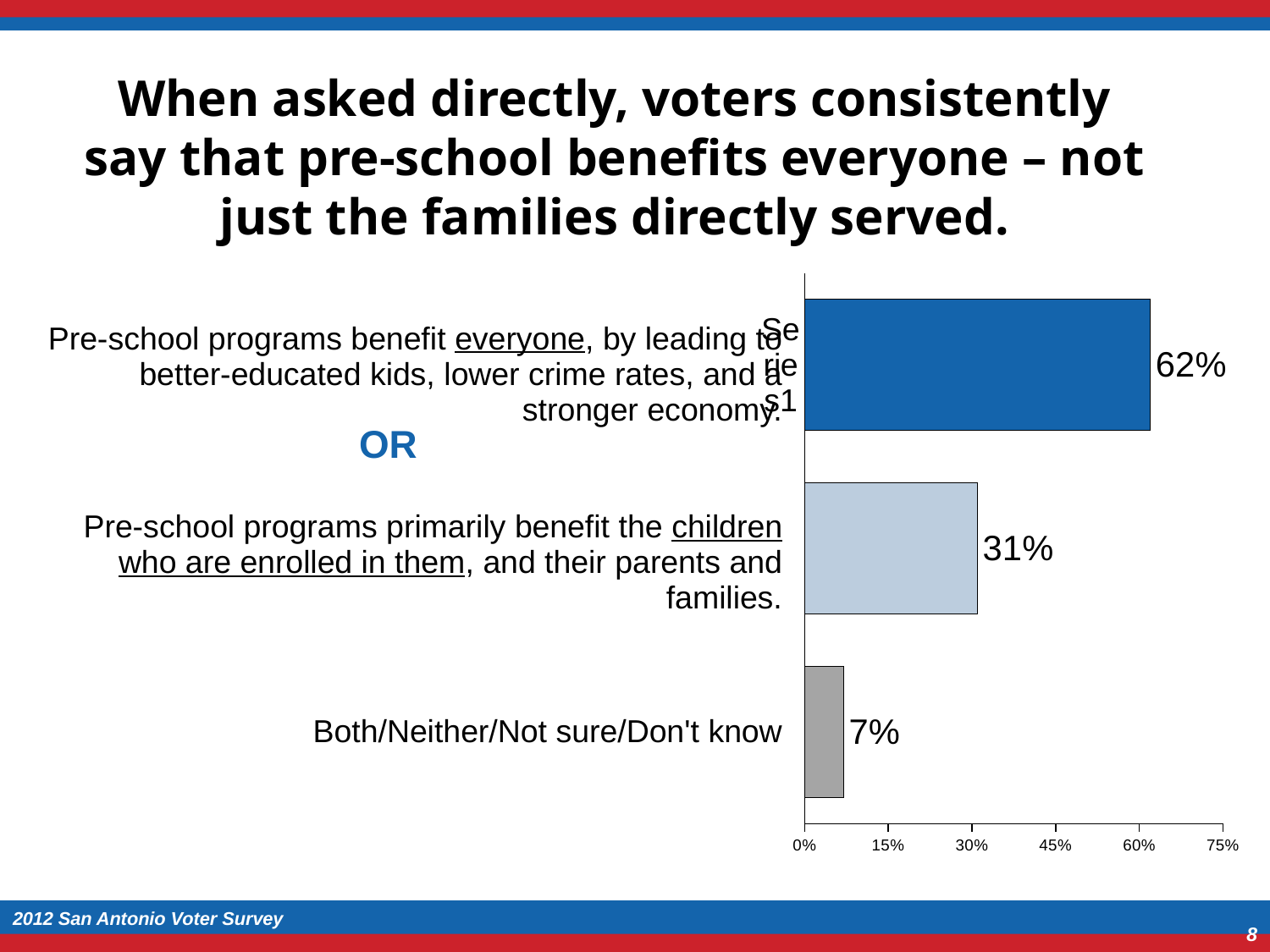
What percentage of voters said pre-school programs benefit everyone? 62% Is the value for 'Pre-school programs benefit everyone' greater or less than 60%? greater Which is larger: the share saying pre-school benefits everyone or the share saying it primarily benefits enrolled children? Benefits everyone How many response categories are shown in the chart? 3 What type of chart is shown on the slide? Bar chart What percentage of voters said pre-school programs primarily benefit the children who are enrolled in them? 31% Which response has the lowest percentage? Both/Neither/Not sure/Don't know What percentage of voters answered Both/Neither/Not sure/Don't know? 7% Which response has the highest percentage? Pre-school programs benefit everyone Is the value for 'Both/Neither/Not sure/Don't know' greater or less than 15%? less What is the difference in percentage points between the 'benefit everyone' response and the 'primarily benefit the children who are enrolled' response? 31 percentage points What is the maximum value shown on the chart's horizontal axis? 75%